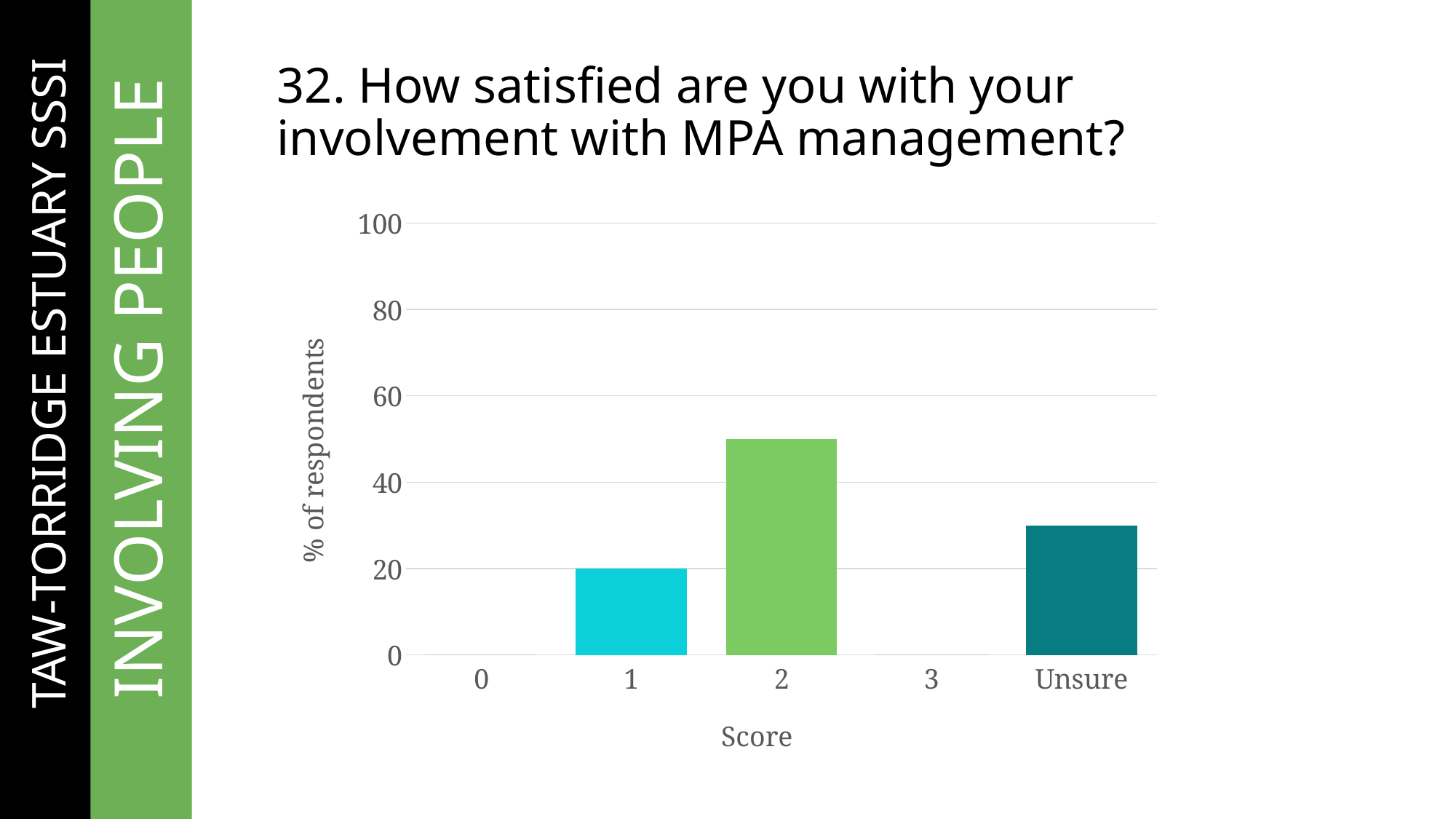
What is the label on the y axis? % of respondents Is the value for Unsure greater or less than 20? greater Which is larger, the value for score 1 or the value for Unsure? Unsure What kind of chart is shown on the slide? bar chart Is the value for Unsure greater or less than 40? less What is the label on the x axis? Score Is the value for score 2 greater or less than 60? less Which score category has the highest percentage of respondents? 2 Which is larger, the value for score 2 or the value for Unsure? score 2 What percentage of respondents gave a score of 1? 20 How many score categories are shown on the x axis? 5